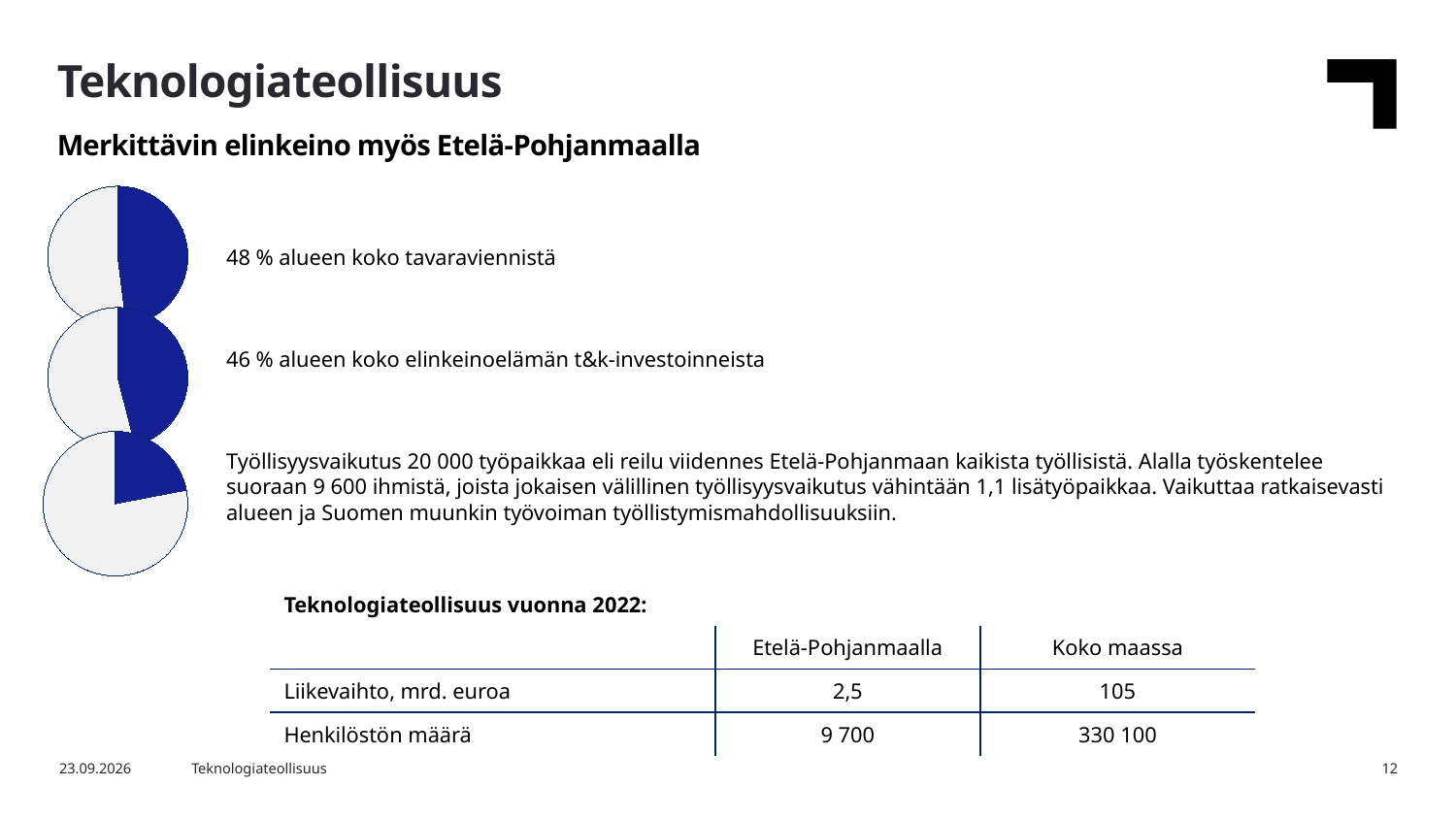
Is the blue slice of the top pie chart greater or less than 25 % of the pie? greater Which pie chart has a larger blue slice, the top one or the bottom one? Top What colour is the highlighted slice in each of the pie charts? Blue Which pie chart has the smallest blue slice: the top, middle or bottom one? Bottom What does the bottom pie chart illustrate, according to the text next to it? Employment impact (työllisyysvaikutus) – a good fifth of all employed in Etelä-Pohjanmaa In the top pie chart, what share of the region's total goods exports (tavaravienti) does the blue slice represent? 48 % How many pie charts are on the slide? 3 In the middle pie chart, what share of the region's business R&D investments (t&k-investoinnit) does the blue slice represent? 46 % What kind of charts are shown on the left side of the slide? Pie charts Is the blue slice of the bottom pie chart greater or less than 50 % of the pie? less Which pie chart has a larger blue slice, the middle one or the bottom one? Middle